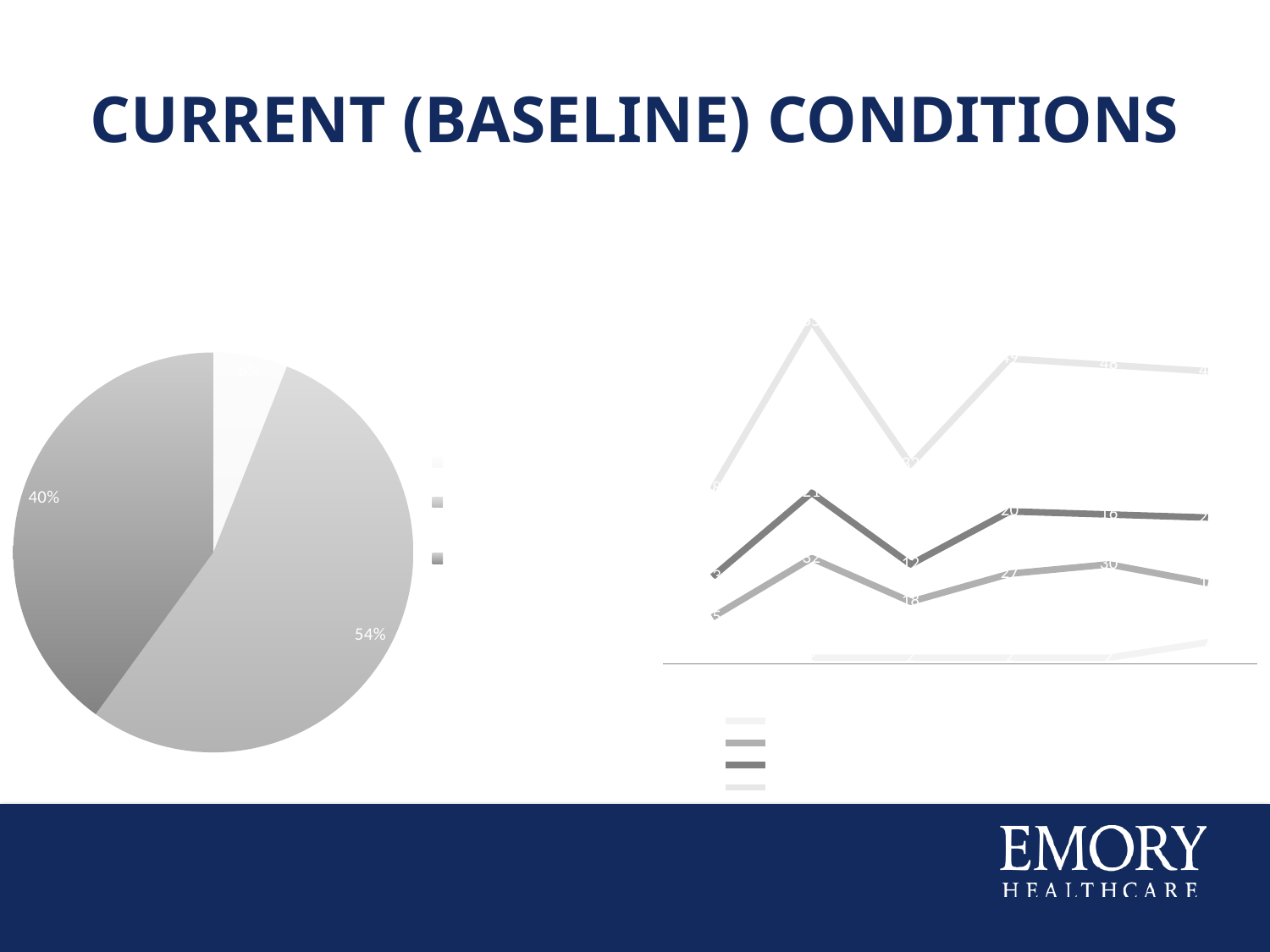
How many slices does the pie chart on the left have? 3 What is the title of the slide containing the charts? CURRENT (BASELINE) CONDITIONS How many data points does each line in the line chart on the right have? 6 In the pie chart on the left, which is larger: the slice labelled 40% or the slice labelled 54%? the slice labelled 54% How many charts are shown on the slide? 2 What kind of chart is on the left side of the slide? pie chart What kind of chart is on the right side of the slide? line chart How many series does the legend of the line chart on the right list? 4 In the pie chart on the left, what is the difference between the slice labelled 54% and the slice labelled 40%? 14 percentage points In the pie chart on the left, what is the value of the largest slice? 54%